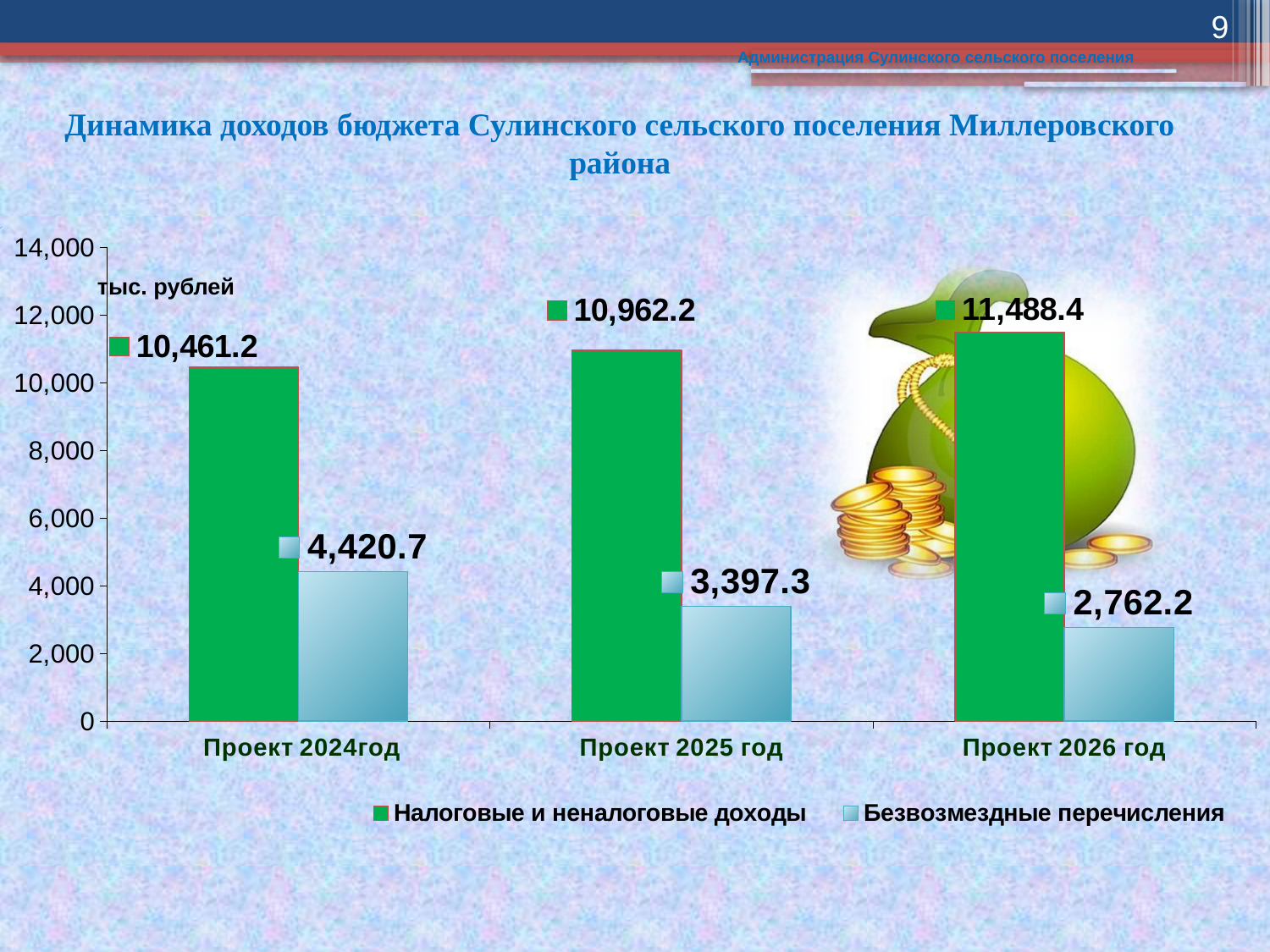
What is the difference between Безвозмездные перечисления in Проект 2024год and Проект 2026 год? 1,658.5 What is the difference between Налоговые и неналоговые доходы in Проект 2026 год and Проект 2024год? 1,027.2 How many series does the legend list? 2 In which year is Безвозмездные перечисления lowest? Проект 2026 год What is the value of Налоговые и неналоговые доходы for Проект 2024год? 10,461.2 Do the values for Безвозмездные перечисления rise or fall from Проект 2024год to Проект 2026 год? Fall Which is larger in Проект 2025 год: Налоговые и неналоговые доходы or Безвозмездные перечисления? Налоговые и неналоговые доходы What is the value of Безвозмездные перечисления for Проект 2026 год? 2,762.2 What is the value of Безвозмездные перечисления for Проект 2025 год? 3,397.3 In which year is Налоговые и неналоговые доходы highest? Проект 2026 год How many categories (years) are shown on the x axis? 3 What kind of chart is shown on the slide? Bar chart